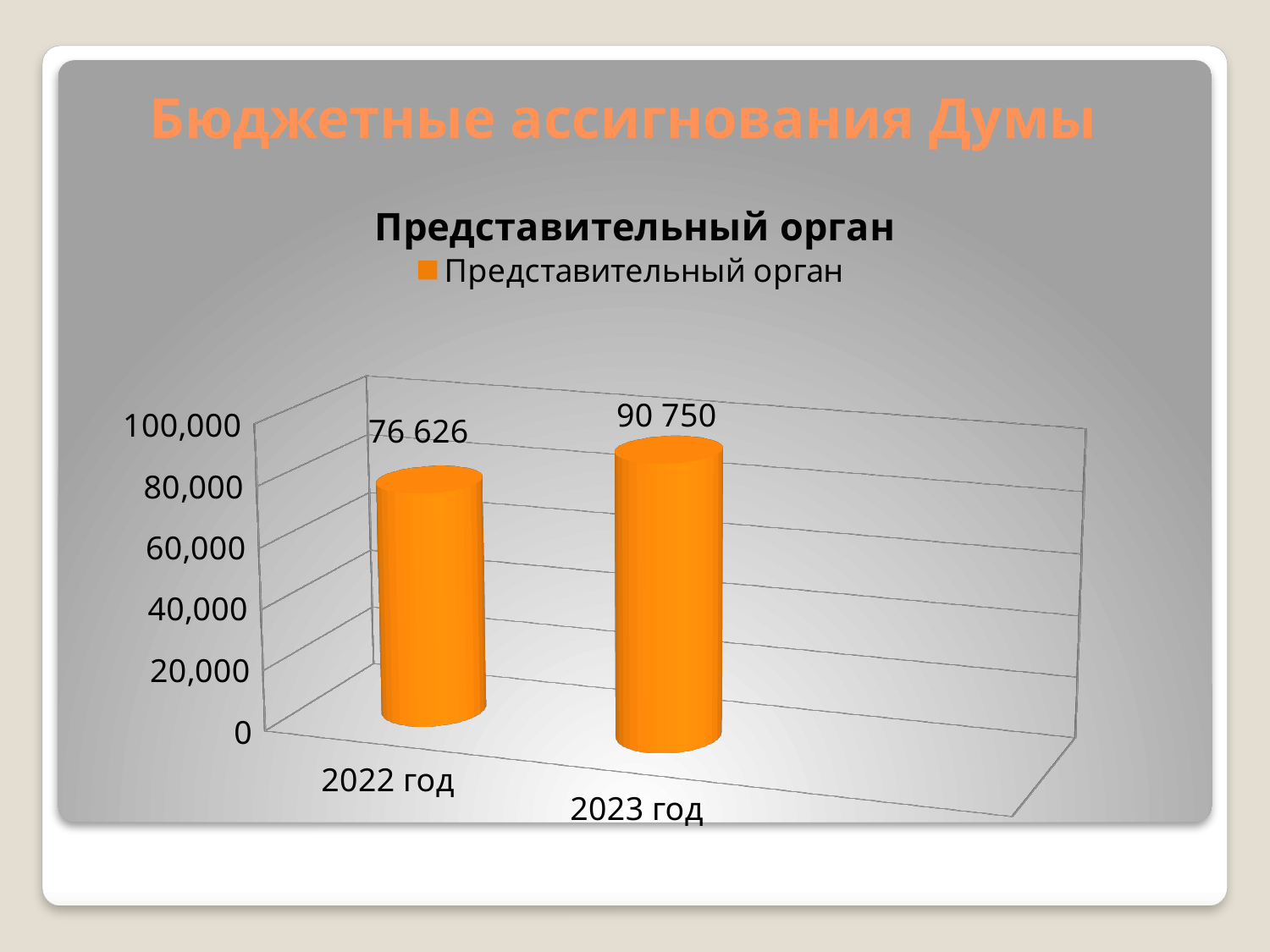
Which is larger, the value for 2022 год or the value for 2023 год? 2023 год How many categories are shown on the chart? 2 What is the value for 2023 год? 90 750 Do the values rise or fall from 2022 год to 2023 год? rise Is the value for 2023 год greater or less than 80,000? greater What is the difference between the values for 2023 год and 2022 год? 14 124 Is the value for 2022 год greater or less than 80,000? less What is the value for 2022 год? 76 626 Which year has the lowest value? 2022 год What kind of chart is shown? bar chart How many series does the legend list? 1 Which year has the highest value? 2023 год